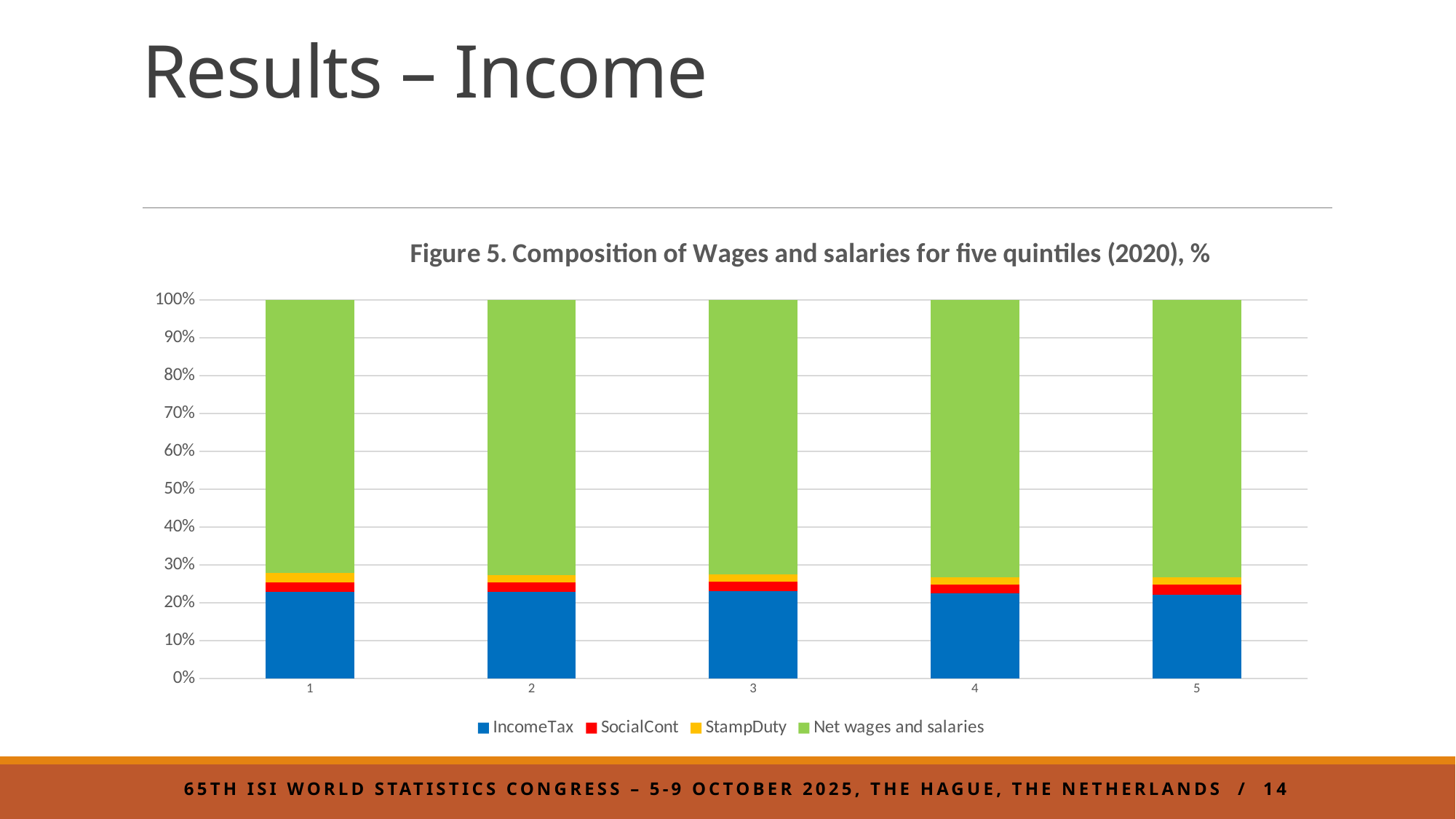
How many series does the legend list? 4 What is the title of the chart? Figure 5. Composition of Wages and salaries for five quintiles (2020), % What is the total height of the stacked bar for quintile 1? 100% Is the IncomeTax share for quintile 5 greater or less than 10%? greater Is the Net wages and salaries share for quintile 3 greater or less than 50%? greater Is the IncomeTax share for quintile 1 greater or less than 30%? less How many quintile categories are shown on the x axis? 5 Which series is shown in green in the legend? Net wages and salaries Which series takes up the largest share of each stacked bar? Net wages and salaries For quintile 4, which is larger: the IncomeTax share or the StampDuty share? IncomeTax What kind of chart is shown on the slide? Stacked bar chart